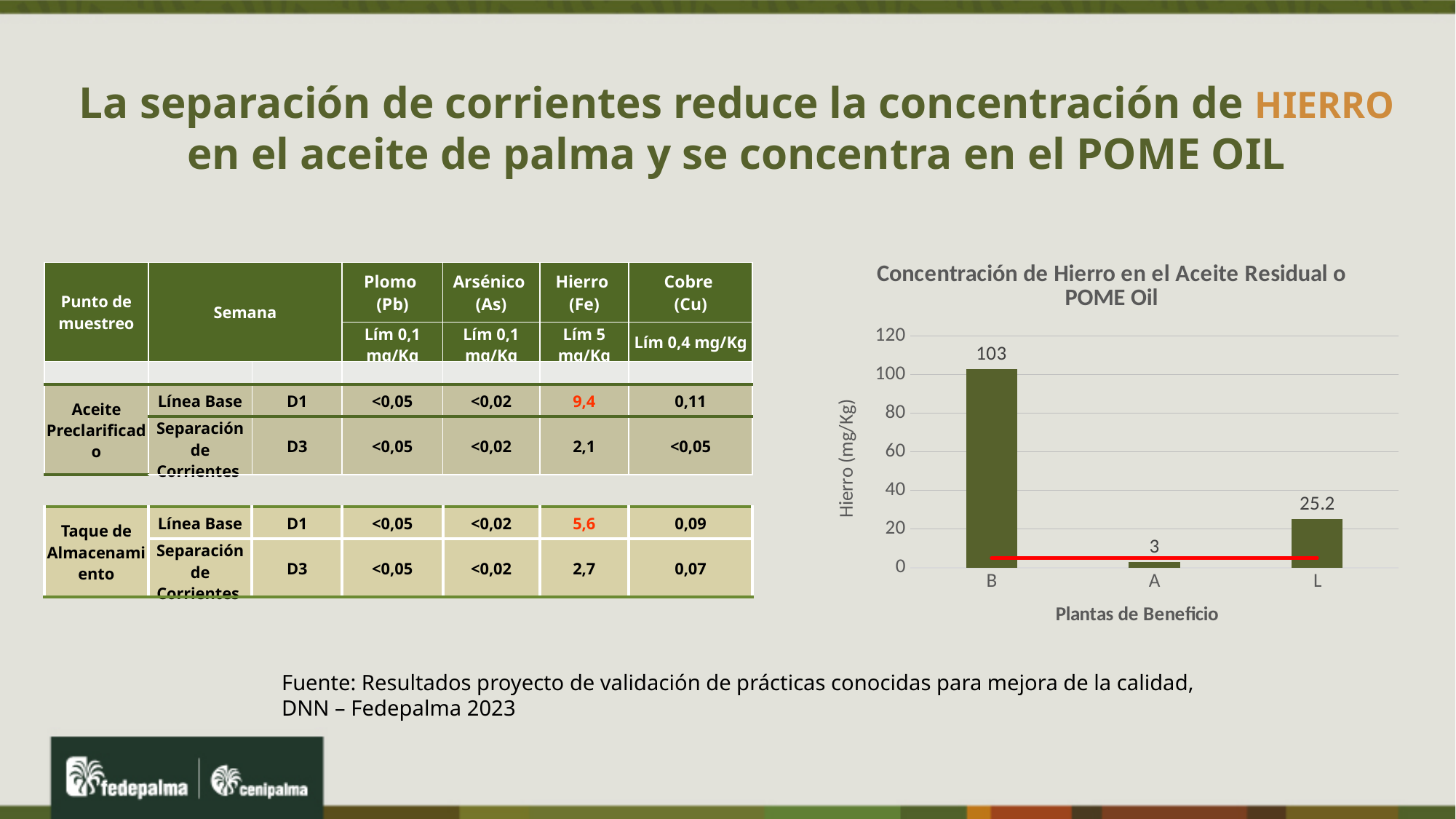
What is the difference between the values for plant B and plant L? 77.8 What is the difference between the values for plant L and plant A? 22.2 How many plants (categories) are shown in the chart? 3 What is the value for plant L in the chart? 25.2 What is the value for plant B in the chart? 103 Which plant has the highest iron concentration in the chart? B Is the value for plant B greater or less than 100? greater Which plant has the lowest iron concentration in the chart? A Which is larger, the value for plant L or the value for plant A? L What is the value for plant A in the chart? 3 What kind of chart is shown on the slide? combination bar and line chart What is the title of the chart? Concentración de Hierro en el Aceite Residual o POME Oil